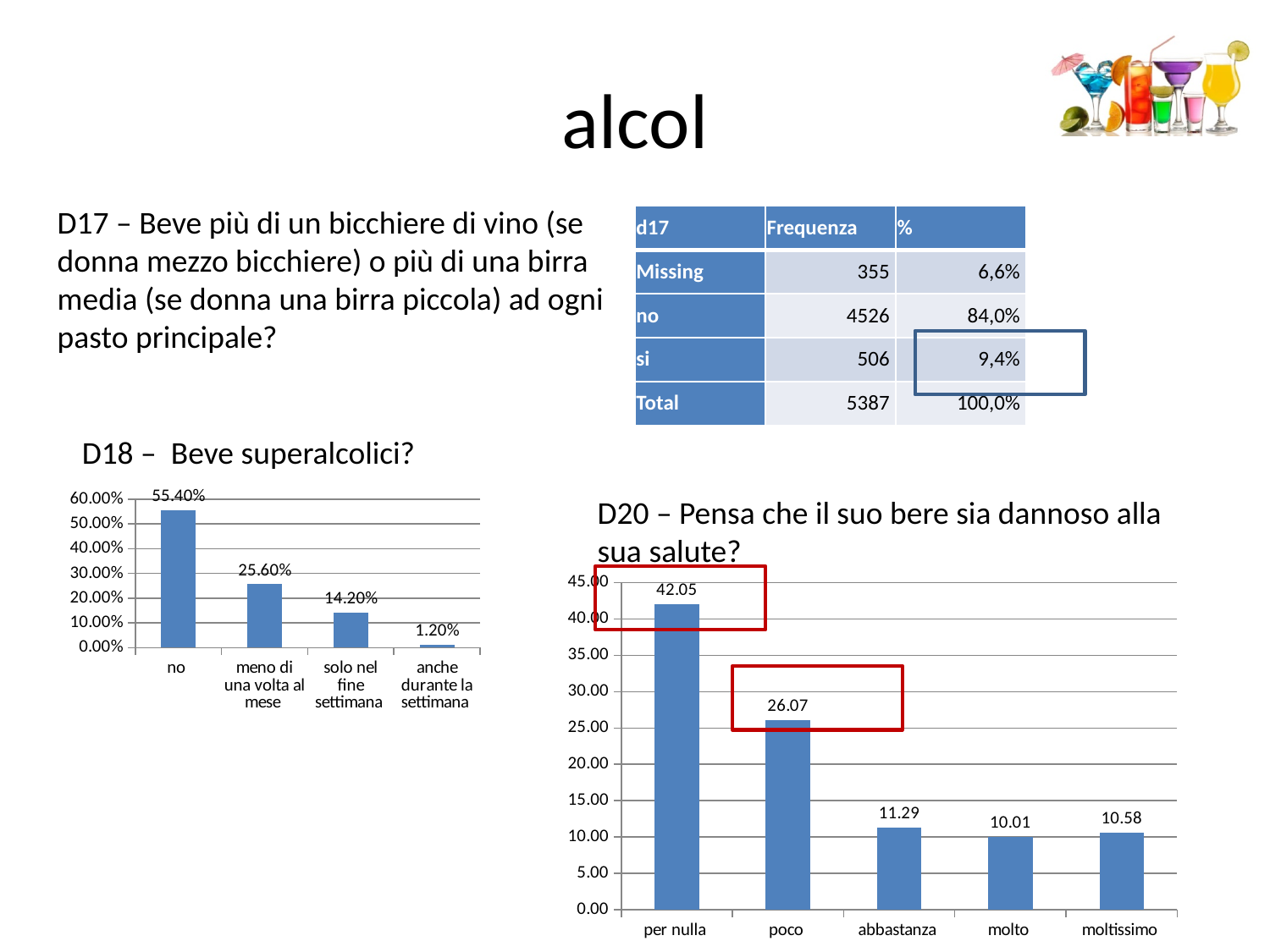
In the D20 chart (Pensa che il suo bere sia dannoso alla sua salute?), what is the value for 'poco'? 26.07 What type of chart is the D20 chart? bar chart In the D18 chart, what is the value for 'solo nel fine settimana'? 14.20% In the D20 chart, what is the value for 'abbastanza'? 11.29 In the D18 chart, what is the difference between 'no' and 'meno di una volta al mese'? 29.80% In the D18 chart, which category has the lowest value? anche durante la settimana In the D20 chart, what is the difference between 'per nulla' and 'poco'? 15.98 In the D20 chart, which category has the highest value? per nulla How many categories are shown in the D18 chart? 4 In the D20 chart, which is larger, 'molto' or 'moltissimo'? moltissimo In the D20 chart, which category has the lowest value? molto In the D18 chart (Beve superalcolici?), what is the value for 'no'? 55.40%